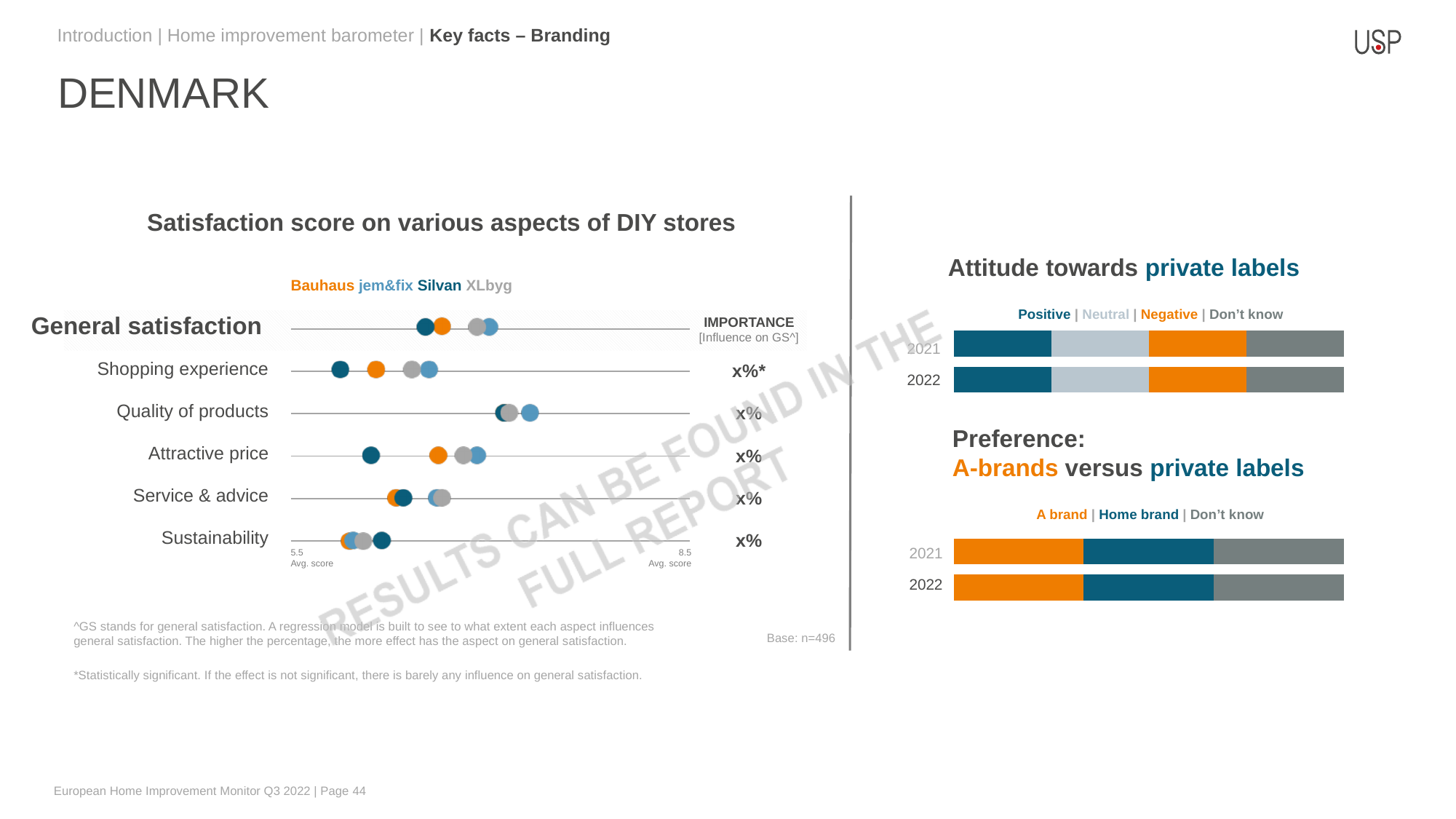
How many aspects are listed in the 'Satisfaction score on various aspects of DIY stores' chart? 6 In the 'Satisfaction score on various aspects of DIY stores' chart, which brand has the lowest score for Shopping experience? Silvan In the 'Satisfaction score on various aspects of DIY stores' chart, which brand has the highest score for Sustainability? Silvan How many series does the legend of the 'Attitude towards private labels' chart list? 4 How many series does the legend of the 'Preference: A-brands versus private labels' chart list? 3 Which brands are listed in the legend of the 'Satisfaction score on various aspects of DIY stores' chart? Bauhaus, jem&fix, Silvan, XLbyg In the 'Satisfaction score on various aspects of DIY stores' chart, which brand has the lowest score for Attractive price? Silvan In the 'Satisfaction score on various aspects of DIY stores' chart, what are the minimum and maximum average scores shown on the axis? 5.5 and 8.5 Which years are shown in the 'Attitude towards private labels' chart? 2021 and 2022 How many DIY store brands does the legend of the 'Satisfaction score on various aspects of DIY stores' chart list? 4 What kind of chart is the 'Attitude towards private labels' chart? Stacked bar chart